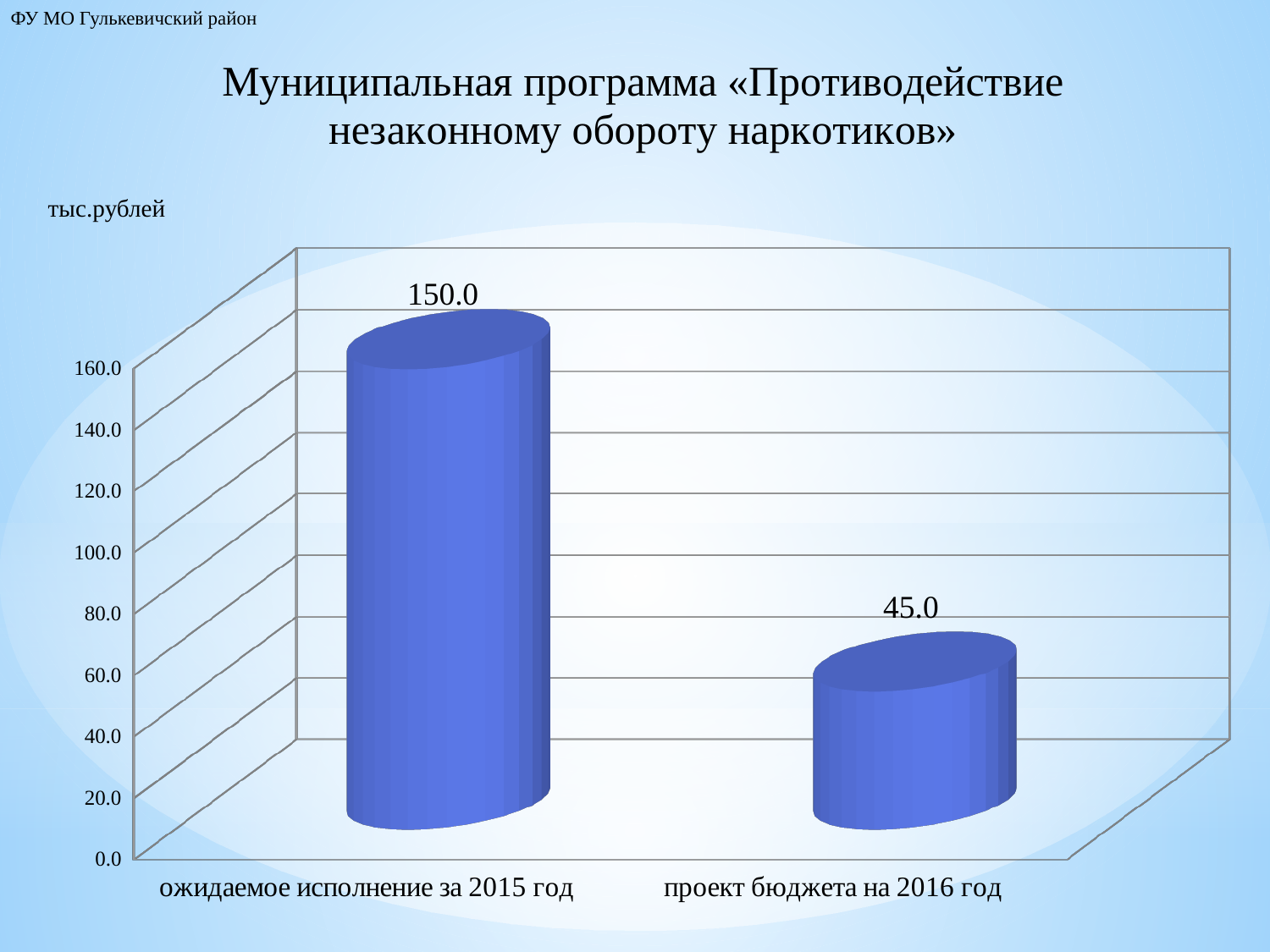
Is the value for «проект бюджета на 2016 год» greater or less than 60.0? less Which is larger: the value for «ожидаемое исполнение за 2015 год» or for «проект бюджета на 2016 год»? ожидаемое исполнение за 2015 год Which category has the highest value? ожидаемое исполнение за 2015 год What unit is indicated above the chart? тыс.рублей What is the value for «проект бюджета на 2016 год»? 45.0 How many categories are shown on the chart? 2 Is the value for «ожидаемое исполнение за 2015 год» greater or less than 140.0? greater Which category has the lowest value? проект бюджета на 2016 год Do the values rise or fall from the 2015 category to the 2016 category? fall What kind of chart is shown on the slide? bar chart What is the value for «ожидаемое исполнение за 2015 год»? 150.0 What is the difference between the value for 2015 and the value for 2016? 105.0